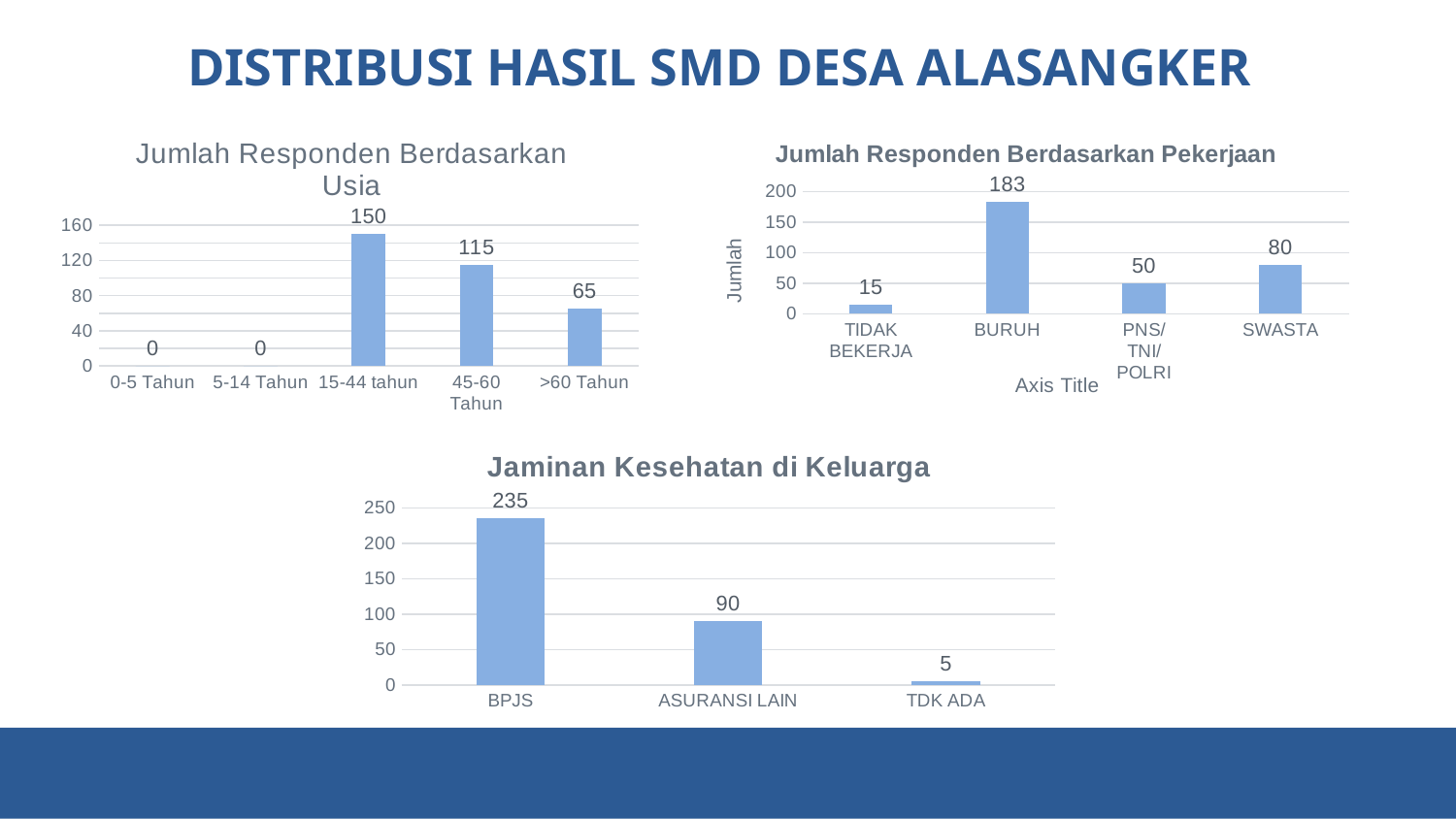
In the 'Jaminan Kesehatan di Keluarga' chart, do the values rise or fall from left to right? Fall In the 'Jumlah Responden Berdasarkan Pekerjaan' chart, what is the value for BURUH? 183 In the 'Jumlah Responden Berdasarkan Usia' chart, which age category has the highest value? 15-44 tahun In the 'Jumlah Responden Berdasarkan Usia' chart, what is the value for 15-44 tahun? 150 How many age categories are shown in the 'Jumlah Responden Berdasarkan Usia' chart? 5 In the 'Jumlah Responden Berdasarkan Usia' chart, what is the difference between the values for 45-60 Tahun and >60 Tahun? 50 In the 'Jumlah Responden Berdasarkan Pekerjaan' chart, which is larger: PNS/TNI/POLRI or SWASTA? SWASTA In the 'Jumlah Responden Berdasarkan Pekerjaan' chart, which category has the lowest value? TIDAK BEKERJA In the 'Jaminan Kesehatan di Keluarga' chart, what is the difference between BPJS and TDK ADA? 230 What is the y-axis title of the 'Jumlah Responden Berdasarkan Pekerjaan' chart? Jumlah What type of chart is 'Jaminan Kesehatan di Keluarga'? Bar chart In the 'Jaminan Kesehatan di Keluarga' chart, what is the value for ASURANSI LAIN? 90